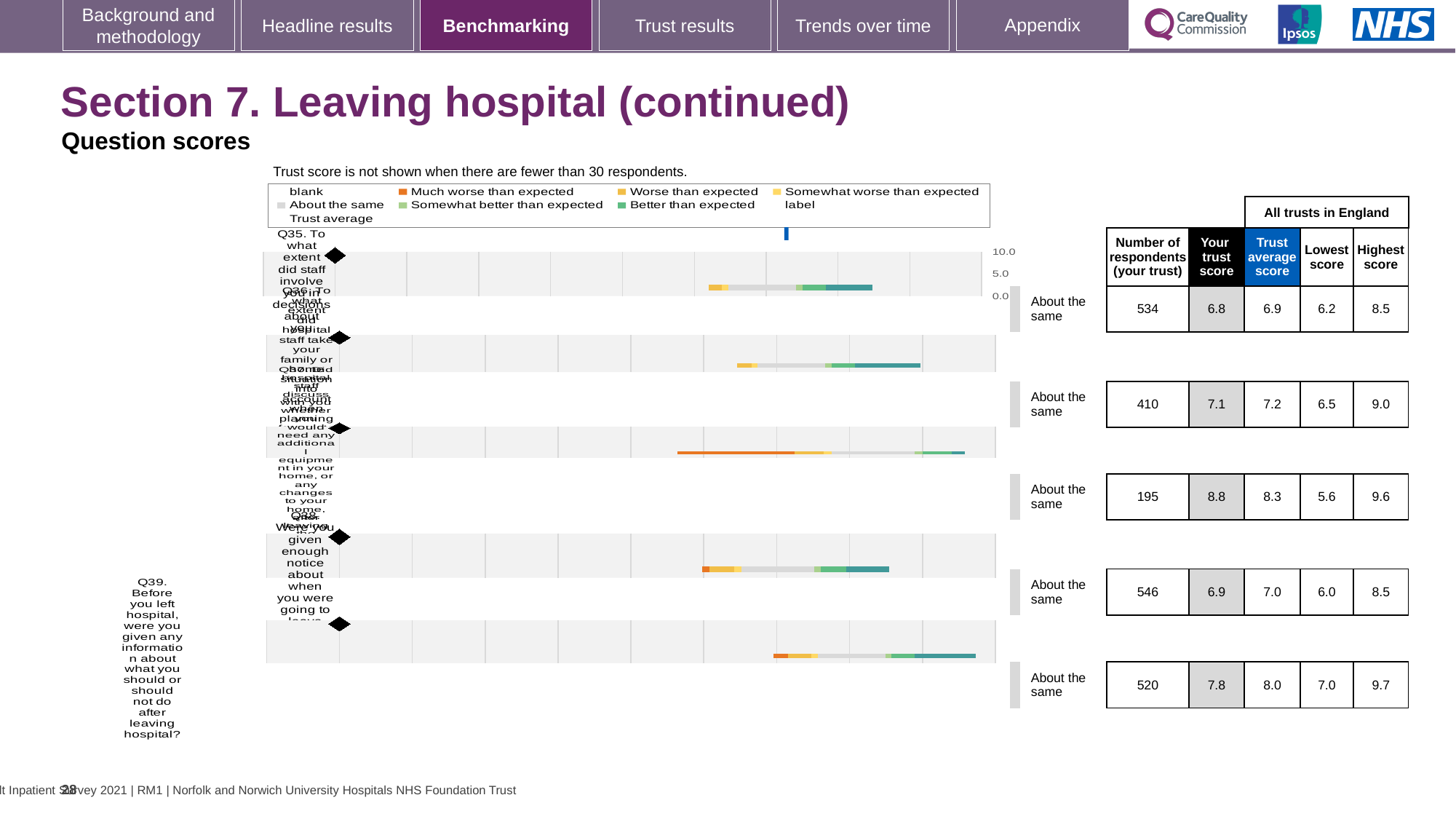
What benchmark category is shown for Q35? About the same Which question has the highest 'Highest score' value in the table? Q39 What is the lowest score across all trusts in England for Q36? 6.5 What is the trust average score for Q39? 8.0 What is the highest score across all trusts in England for Q38? 8.5 How many questions are shown on this slide? 5 What is your trust score for Q37? 8.8 Which has more respondents from your trust, Q38 or Q39? Q38 How many respondents from your trust answered Q35? 534 Which question has the fewest respondents from your trust? Q37 What is the difference between your trust score and the trust average score for Q37? 0.5 What kind of chart is used to show the question scores? Bar chart